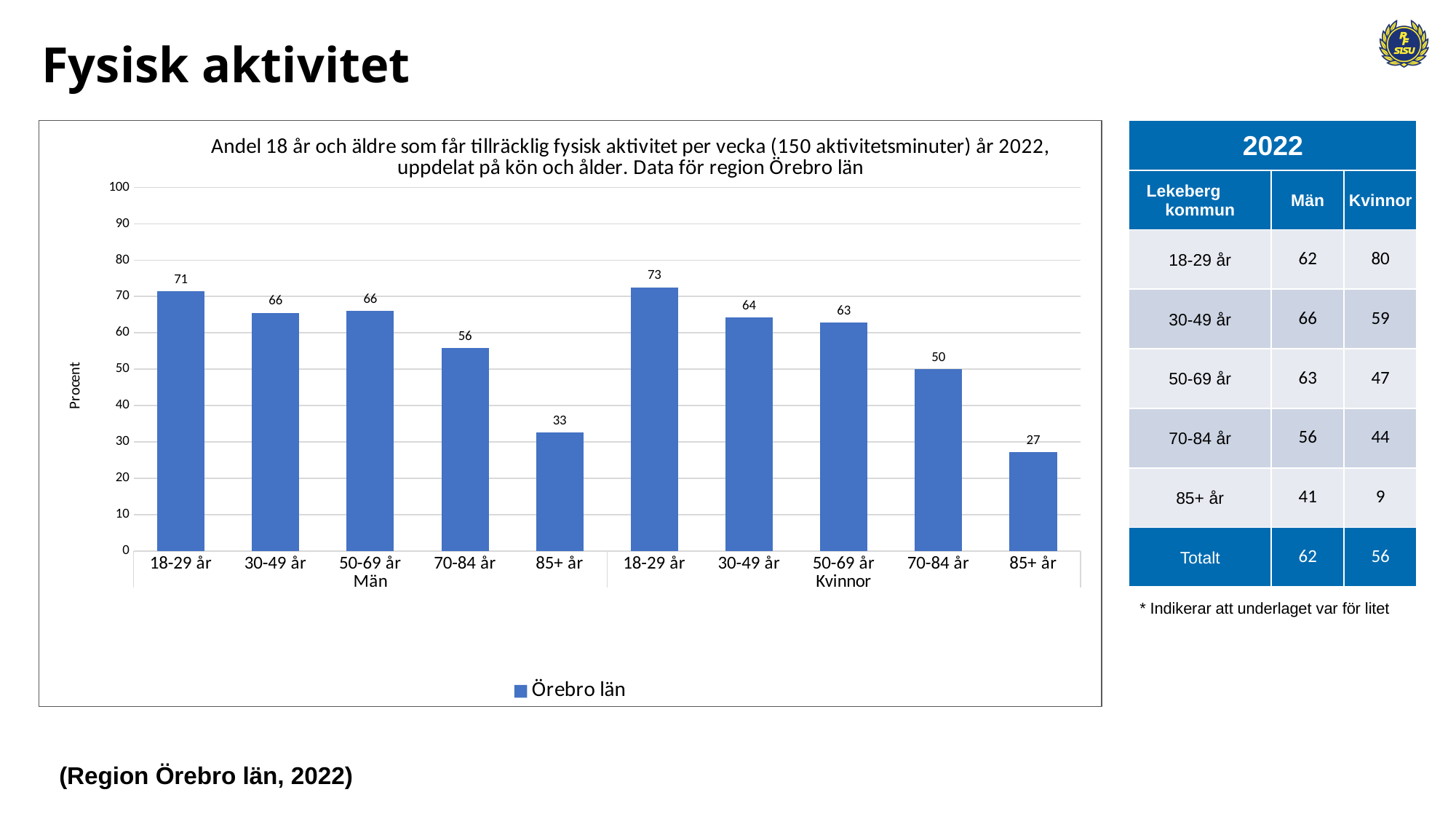
Which group has the highest value in the chart? Kvinnor 18-29 år Is the value for men aged 85+ år greater or less than 40? less What is the legend entry of the chart? Örebro län Which group has the lowest value in the chart? Kvinnor 85+ år What is the value for women aged 70-84 år in the chart? 50 How many series does the legend list? 1 What is the difference between men aged 18-29 år and men aged 85+ år? 38 Which is larger: the value for men aged 70-84 år or women aged 70-84 år? Men aged 70-84 år What kind of chart is shown on the slide? Bar chart What is the value for men aged 18-29 år in the chart? 71 What is the value for women aged 85+ år in the chart? 27 How many bars are plotted in the chart? 10